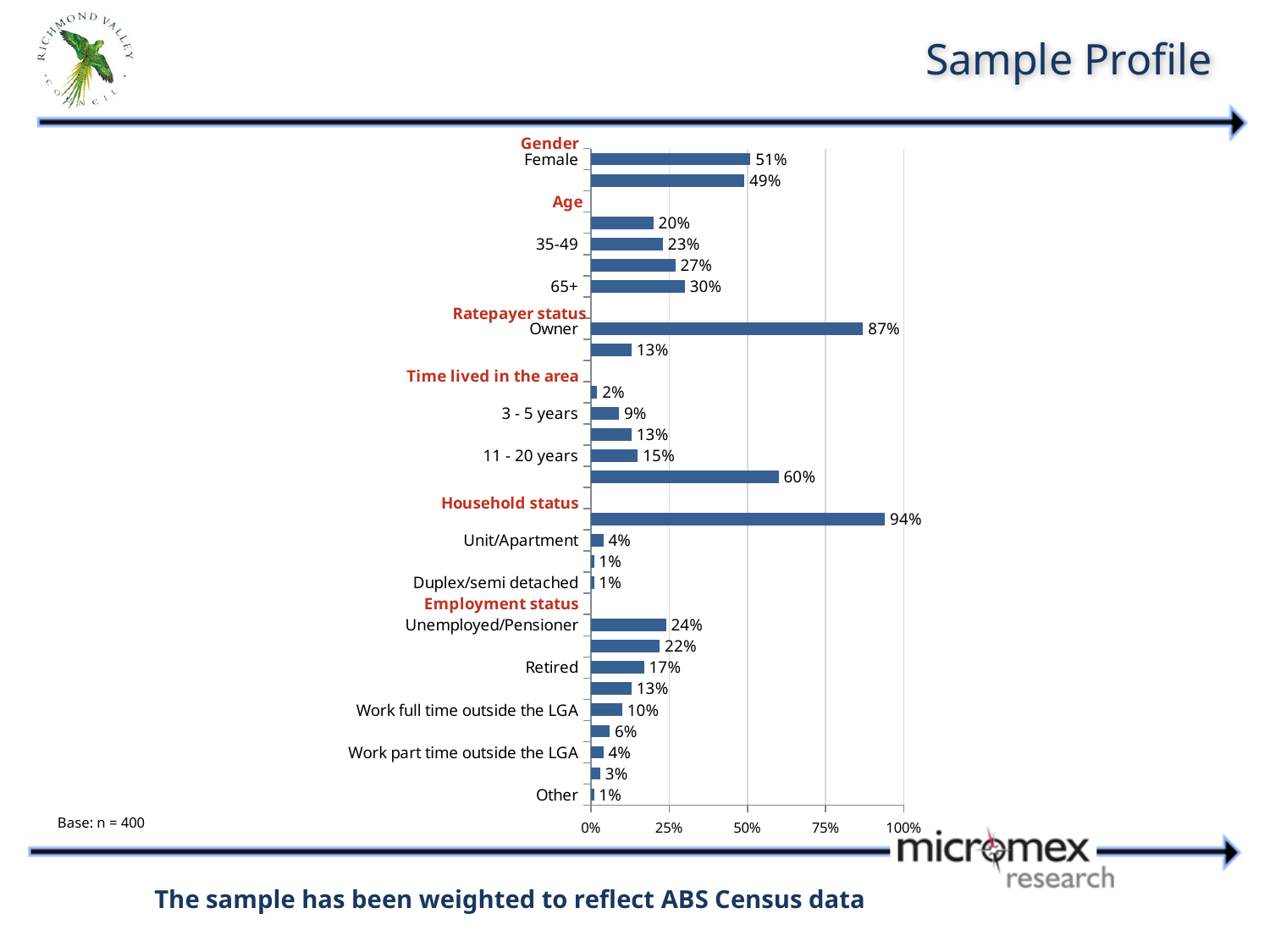
Is the value for Owner greater or less than 75%? greater What kind of chart is shown on the slide? Bar chart What percentage of respondents are Retired? 17% What is the highest value shown on the chart? 94% Which is larger, Unemployed/Pensioner or Retired? Unemployed/Pensioner What is the base sample size noted on the slide? n = 400 What percentage of the sample is Female? 51% What is the difference between the 65+ and 35-49 age groups? 7% What percentage of respondents are Owners under Ratepayer status? 87% What is the value for Work full time outside the LGA? 10% What is the value for the 65+ age group? 30% What is the value for 11 - 20 years under Time lived in the area? 15%